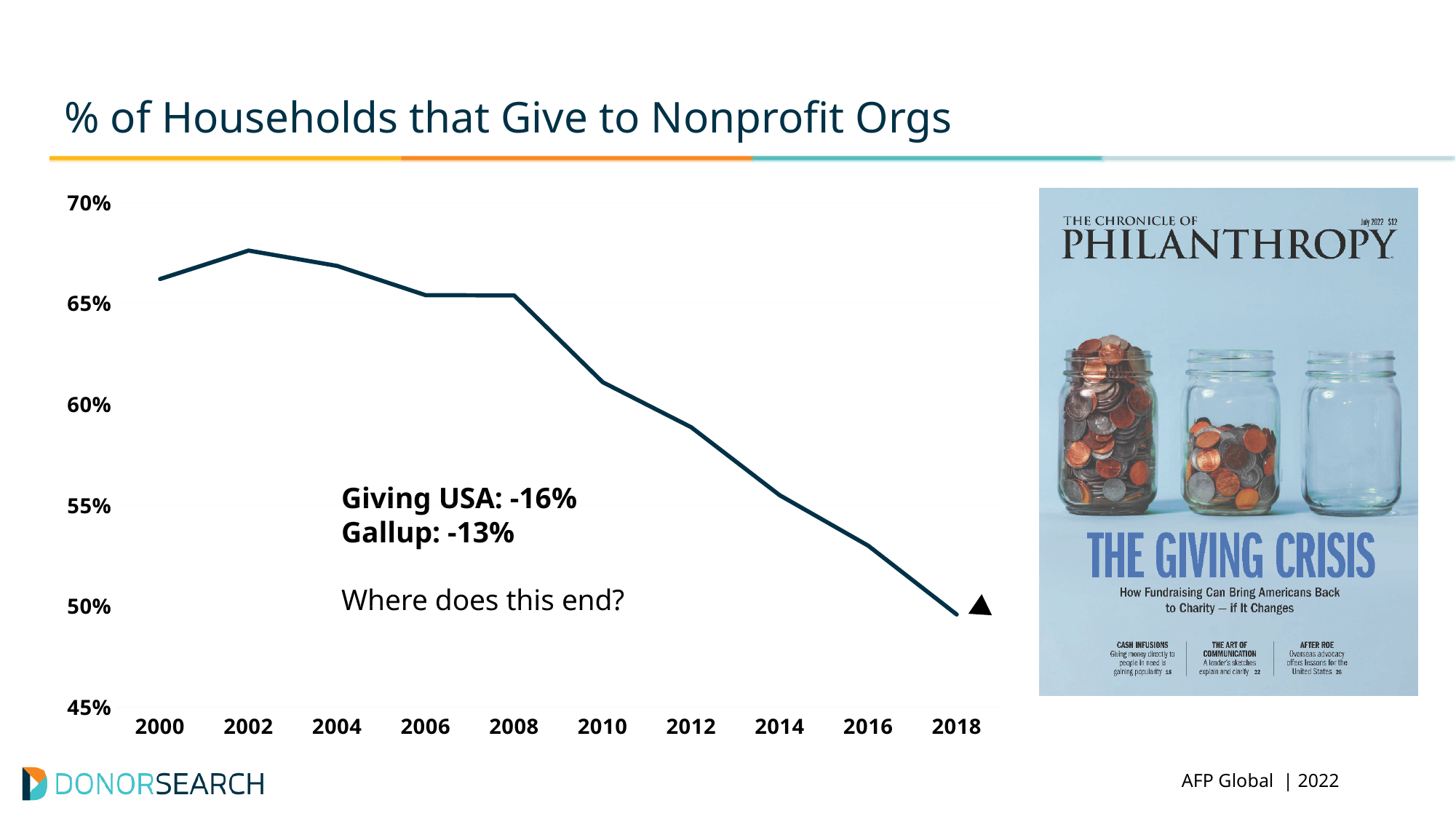
Is the value for 2016 greater or less than 55%? less Does the percentage of households that give rise or fall between 2008 and 2018? fall How many years are plotted along the x axis? 10 Is the value for 2004 greater or less than 65%? greater Which year has the highest percentage of households giving? 2002 Which year has the lowest percentage of households giving? 2018 Is the value for 2010 greater or less than 60%? greater What is the title of the chart? % of Households that Give to Nonprofit Orgs Which year has a higher value, 2002 or 2018? 2002 What kind of chart is shown on the slide? line chart Which year has a higher value, 2000 or 2012? 2000